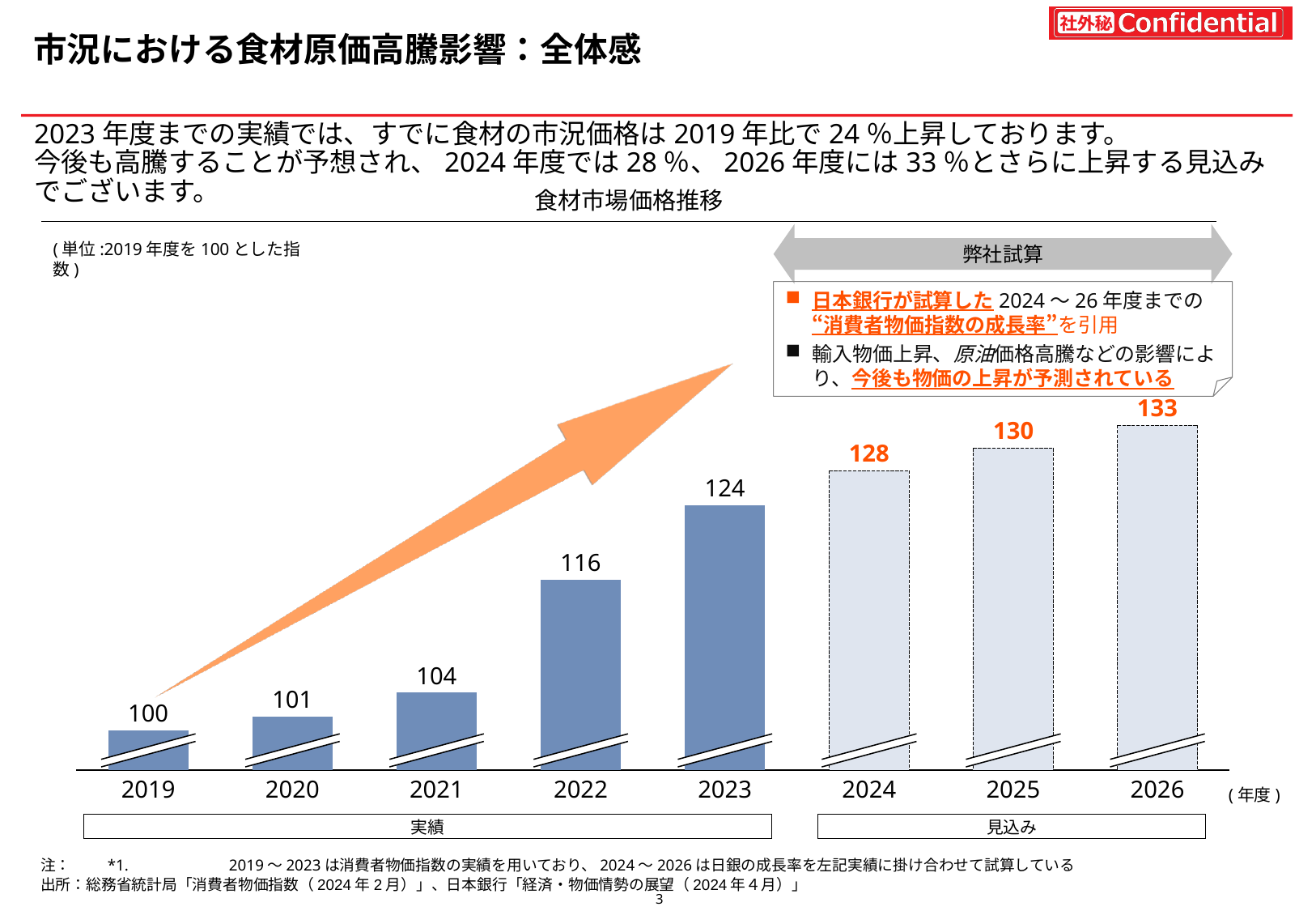
Do the values rise or fall from 2019 to 2026? Rise What is the value for 2023 in the 食材市場価格推移 chart? 124 What kind of chart is shown on the slide? Bar chart What is the difference between the values for 2023 and 2019? 24 Which year has the highest value in the chart? 2026 Which year has the lowest value in the chart? 2019 How many years (bars) are shown in the chart? 8 Which is larger, the value for 2020 or the value for 2025? 2025 What is the value for 2021 in the chart? 104 What is the difference between the values for 2024 and 2022? 12 What is the title of the chart? 食材市場価格推移 What is the value for 2026 in the chart? 133